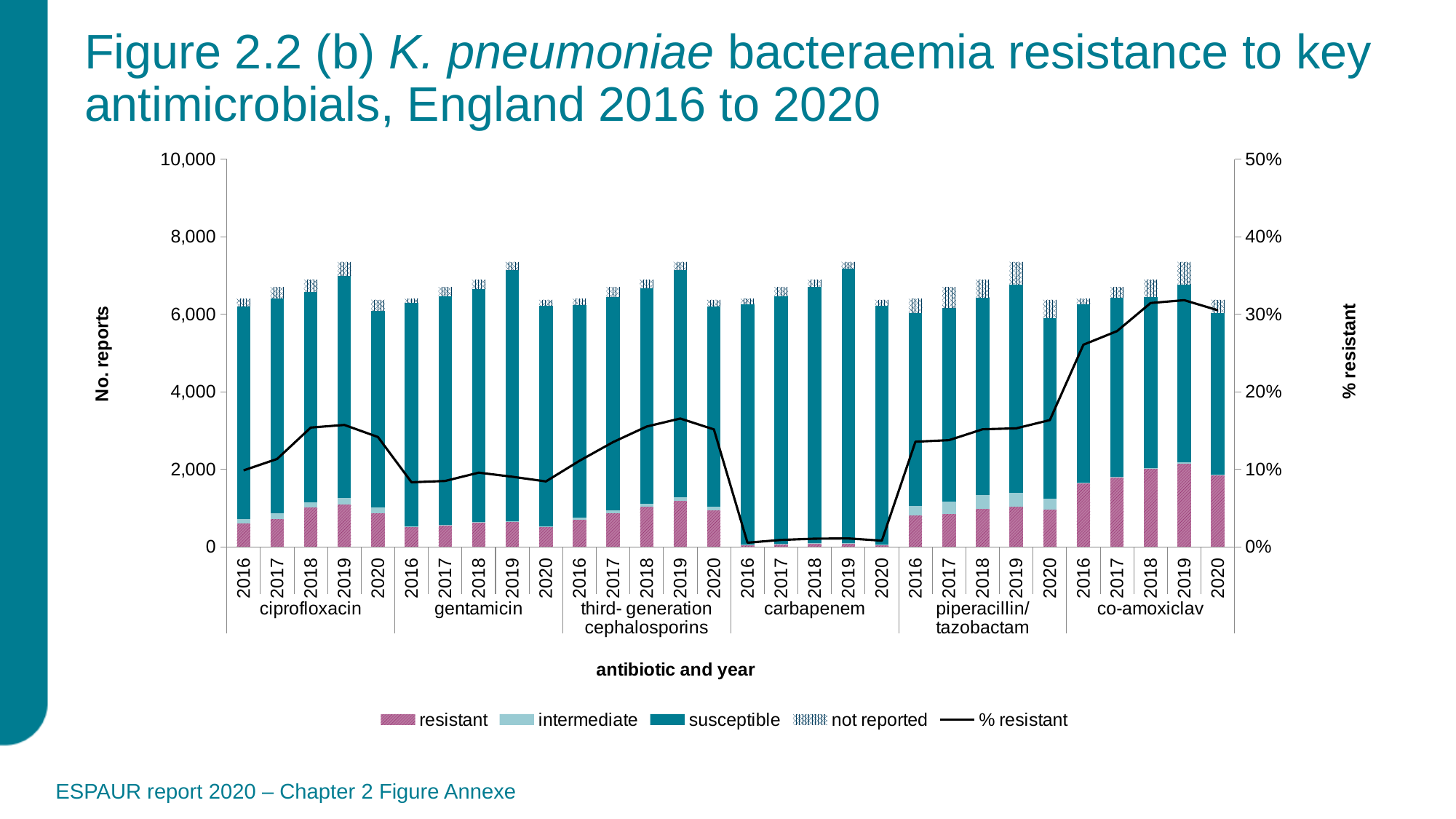
Which antibiotic has the highest % resistant line values across all years? co-amoxiclav Is the % resistant value for third-generation cephalosporins in 2019 greater or less than 10%? greater Is the % resistant value for co-amoxiclav in 2019 greater or less than 30%? greater Which antibiotic has the lowest % resistant line values across all years? carbapenem Is the % resistant value for carbapenem in 2018 greater or less than 5%? less How many entries does the legend list? 5 How many antibiotic groups are shown along the x axis? 6 How many bars are plotted in total on the chart? 30 What is the label of the left vertical axis? No. reports Does the % resistant line for co-amoxiclav rise or fall from 2016 to 2019? rise What kind of chart is shown on the slide? stacked bar chart with a line